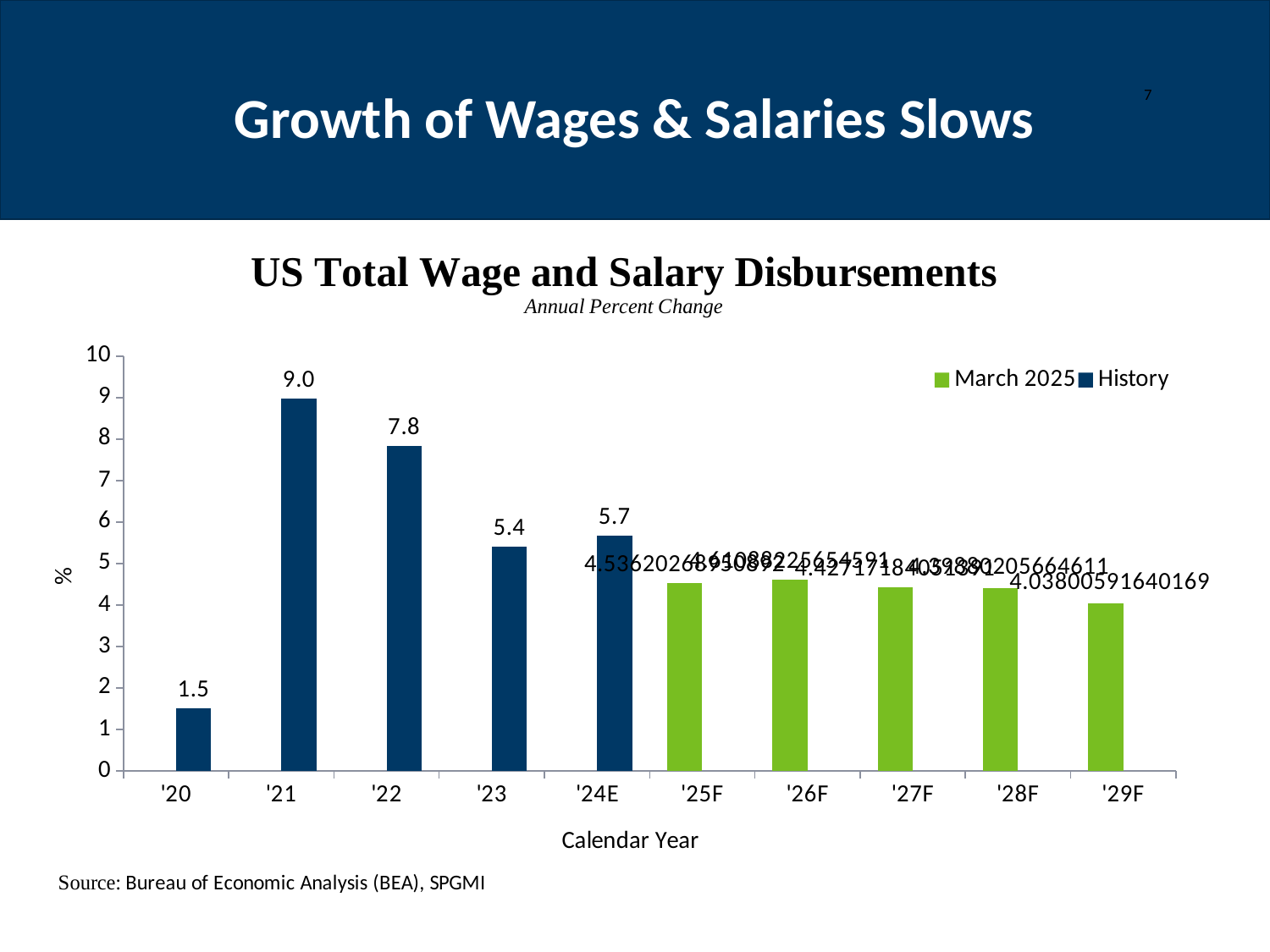
What kind of chart is this? bar chart Do the values rise or fall from '21 to '23? fall What is the value for '20? 1.5 How many series does the legend list? 2 How many years are shown on the x axis? 10 What is the value for '21? 9.0 What is the value for '24E? 5.7 Which year has the highest value? '21 Which year has the lowest value? '20 What is the difference between the values for '21 and '22? 1.2 Is the value for '29F greater or less than 5? less Which is larger, the value for '22 or the value for '23? '22